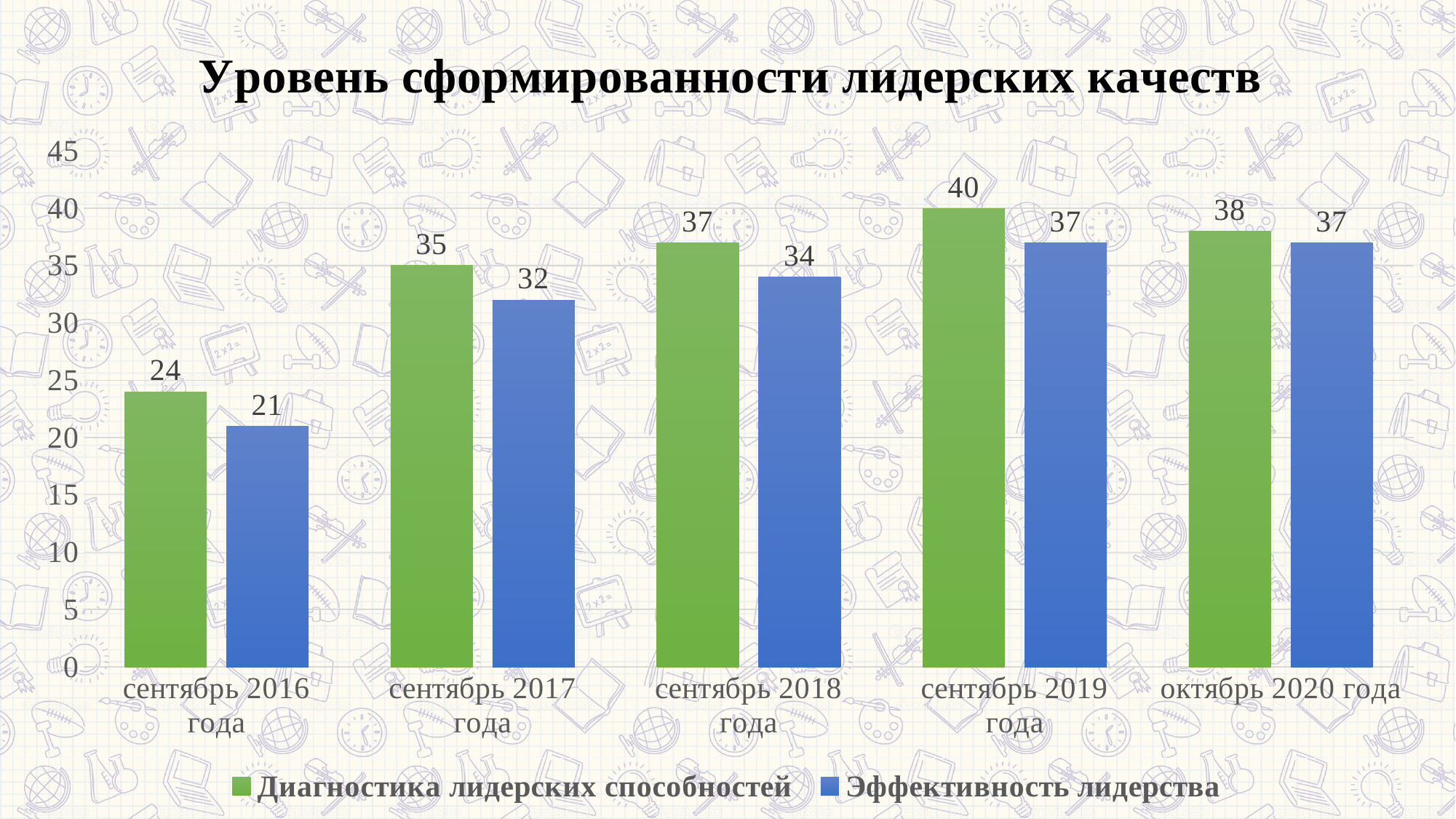
Which is larger for сентябрь 2019 года: Диагностика лидерских способностей or Эффективность лидерства? Диагностика лидерских способностей What is the value of Эффективность лидерства for сентябрь 2018 года? 34 How many series does the legend list? 2 What is the title of the chart? Уровень сформированности лидерских качеств What is the difference between Диагностика лидерских способностей and Эффективность лидерства for сентябрь 2017 года? 3 In which period is Эффективность лидерства lowest? сентябрь 2016 года What is the value of Диагностика лидерских способностей for сентябрь 2016 года? 24 What kind of chart is shown on the slide? bar chart In which period is Диагностика лидерских способностей highest? сентябрь 2019 года Does Эффективность лидерства rise or fall from сентябрь 2016 года to сентябрь 2019 года? rise How many periods are shown on the x axis? 5 What is the value of Эффективность лидерства for октябрь 2020 года? 37